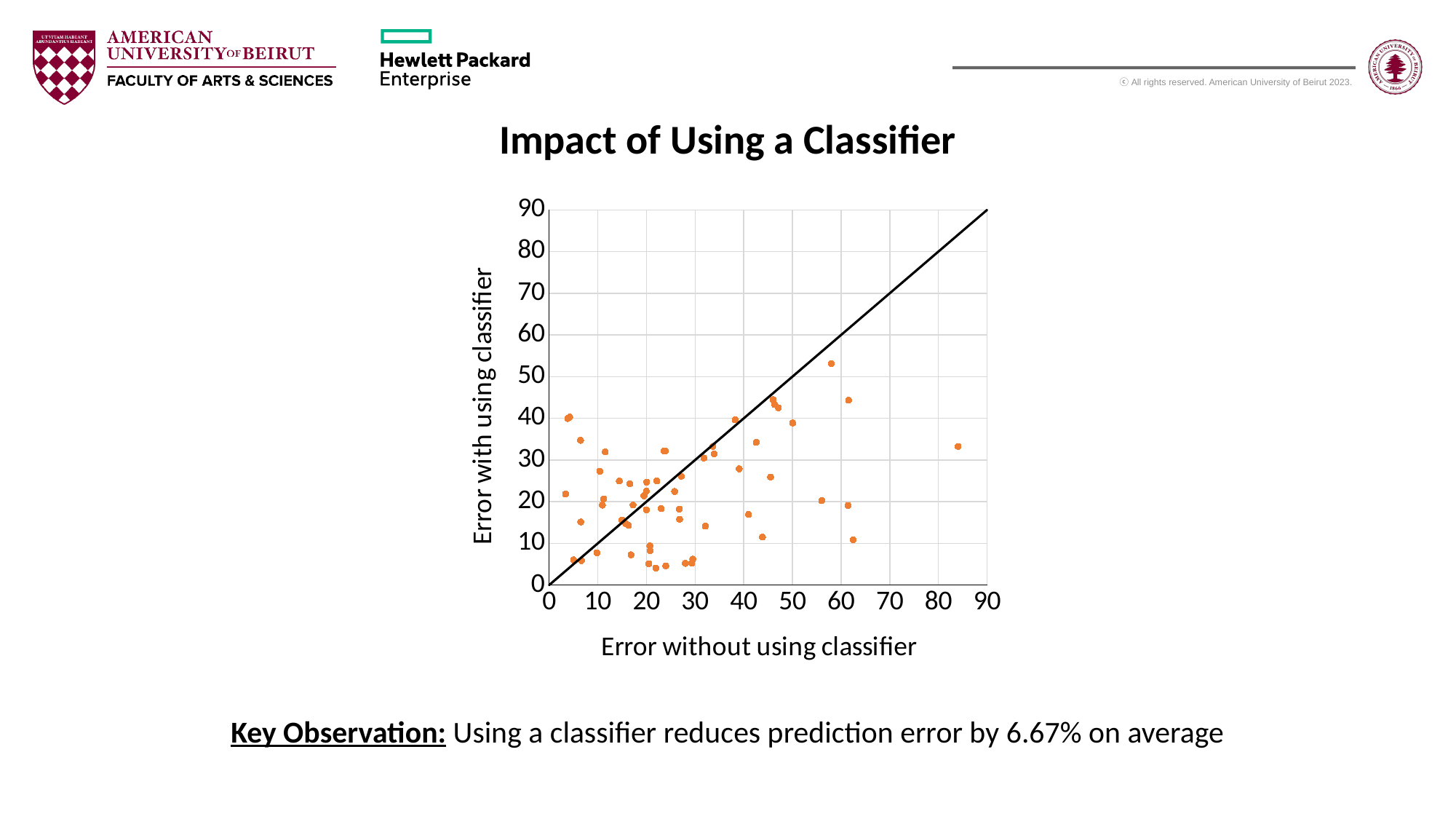
Is the y value of the rightmost point on the chart greater or less than 40? less Is the x value of the rightmost point on the chart greater or less than 80? greater What kind of chart is shown on the slide? scatter plot What is the title of the chart? Impact of Using a Classifier Is the y value of the highest point on the chart greater or less than 60? less What is the label of the x axis of the chart? Error without using classifier